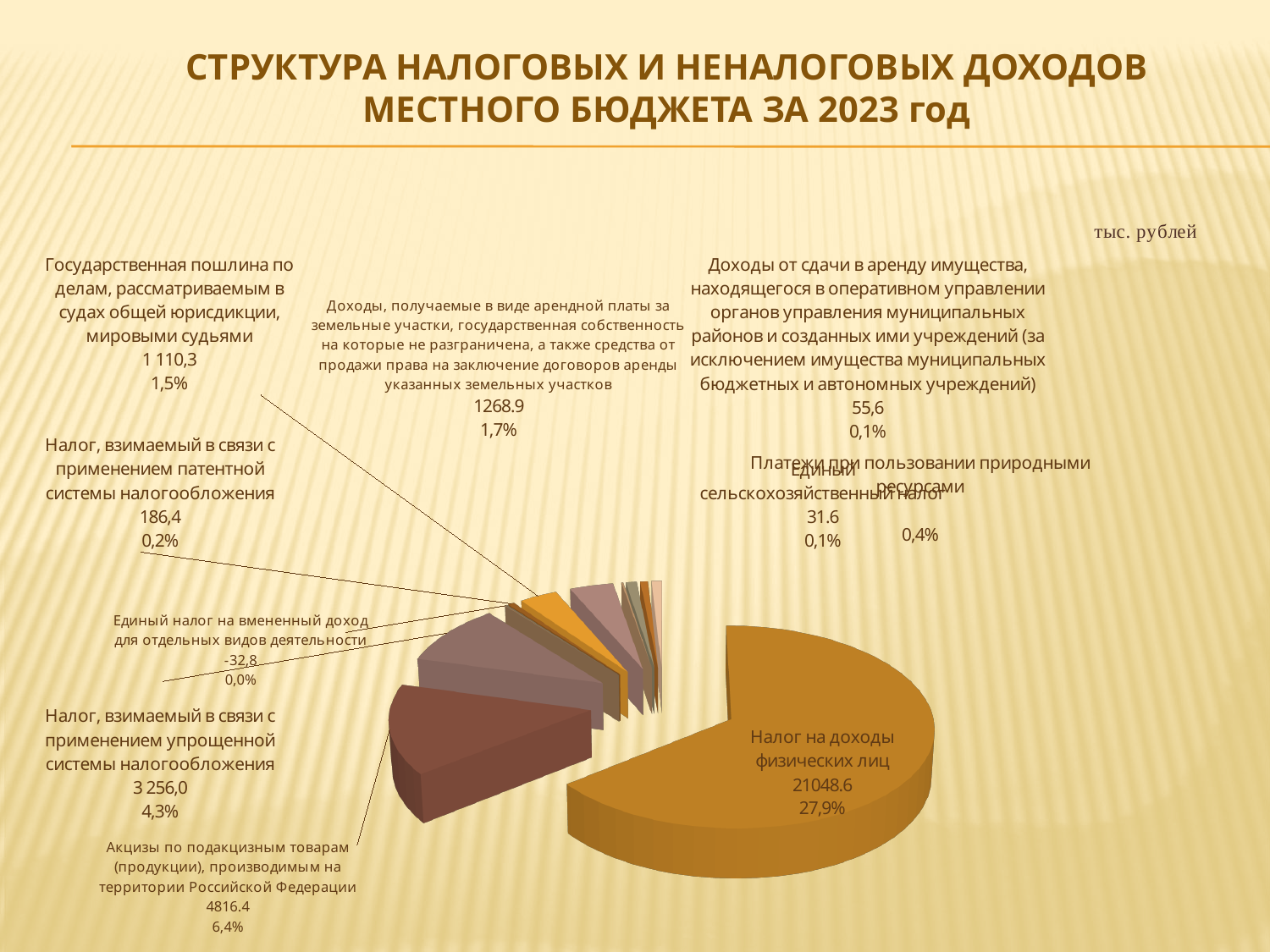
Which is larger: the value for Акцизы по подакцизным товарам or the value for Налог, взимаемый в связи с применением упрощенной системы налогообложения? Акцизы по подакцизным товарам Which category has the largest slice of the pie? Налог на доходы физических лиц What percentage share is shown for Налог, взимаемый в связи с применением патентной системы налогообложения? 0,2% In what units are the values on the chart given? тыс. рублей What is the value shown for Налог, взимаемый в связи с применением упрощенной системы налогообложения? 3 256,0 What is the value shown for Налог на доходы физических лиц? 21048.6 What percentage share is shown for Налог на доходы физических лиц? 27,9% What is the value shown for Государственная пошлина по делам, рассматриваемым в судах общей юрисдикции, мировыми судьями? 1 110,3 Which category has the lowest value on the chart? Единый налог на вмененный доход для отдельных видов деятельности What is the value shown for Акцизы по подакцизным товарам (продукции), производимым на территории Российской Федерации? 4816.4 What is the value shown for Единый налог на вмененный доход для отдельных видов деятельности? -32,8 What kind of chart is shown on the slide? Pie chart